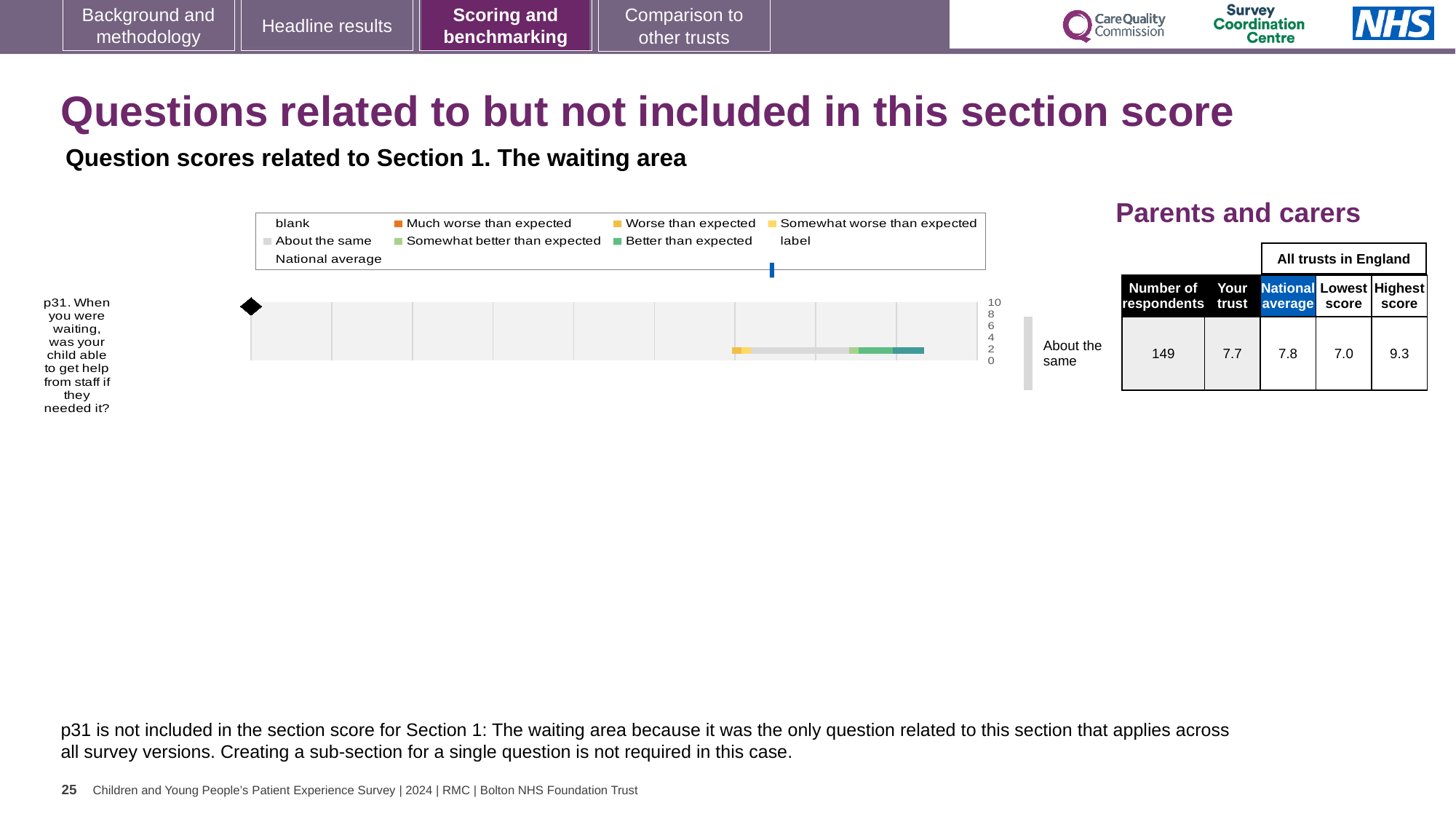
What is the highest score among all trusts in England for p31? 9.3 What is the difference between the highest and lowest trust scores for p31? 2.3 What benchmark category label is shown next to the p31 bar? About the same What is the 'Your trust' score for p31 (When you were waiting, was your child able to get help from staff if they needed it?)? 7.7 How many questions are plotted in the chart? 1 What is the lowest score among all trusts in England for p31? 7.0 Which is larger for p31: the 'Your trust' score or the national average? National average What is the national average score for p31? 7.8 What is the maximum value shown on the chart's score axis? 10 How many respondents answered p31? 149 What is the difference between the national average and the 'Your trust' score for p31? 0.1 What type of chart is used to show the p31 question score? bar chart